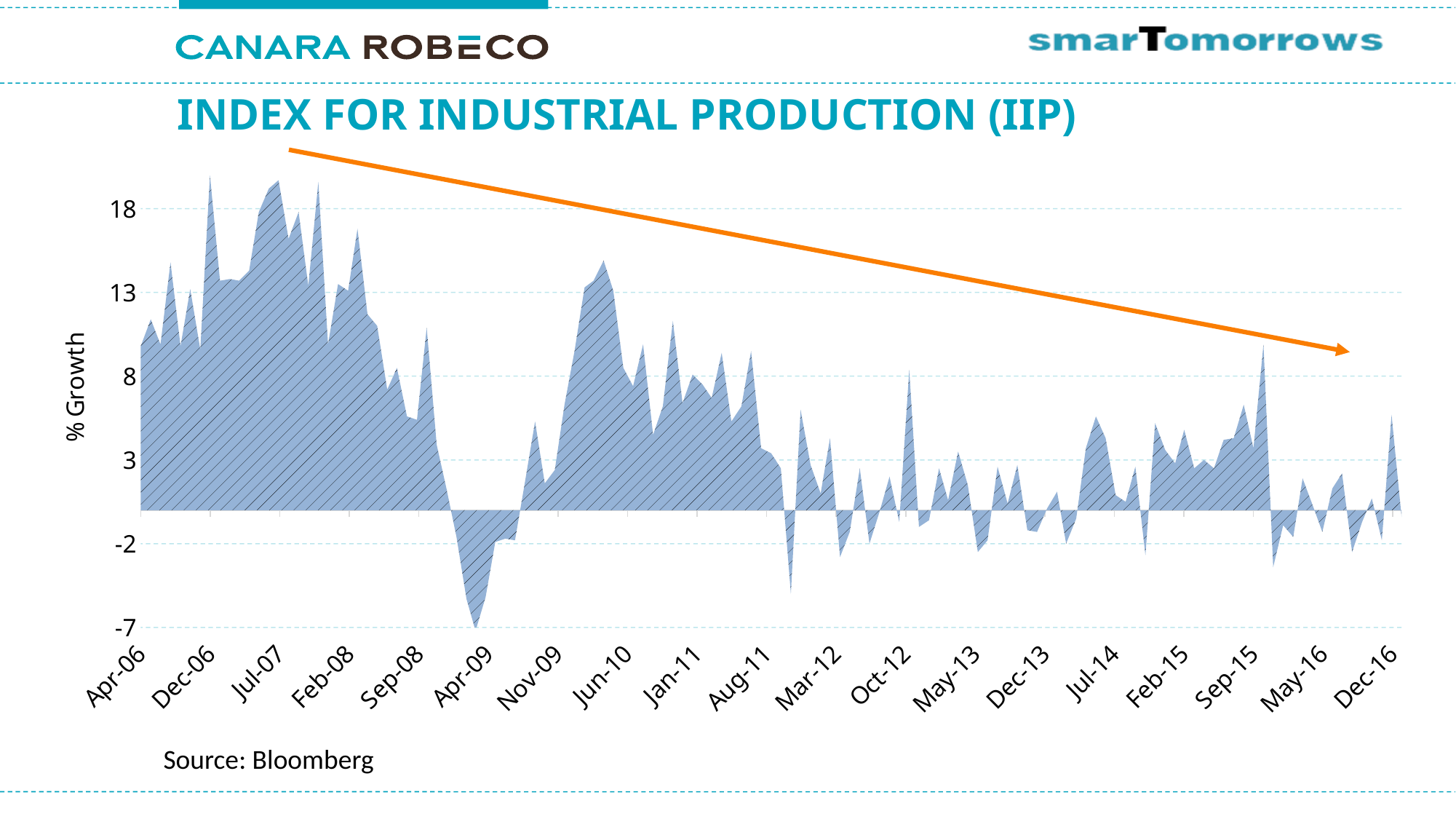
What is the title of the chart? INDEX FOR INDUSTRIAL PRODUCTION (IIP) Is the value for Nov-09 greater or less than 3? greater Is the value for Apr-06 greater or less than 8? greater How many date labels are shown along the x axis? 19 What is the lowest tick value shown on the vertical axis? -7 Is the value for Jul-07 greater or less than 13? greater What is the label on the vertical axis of the chart? % Growth Over the whole period from Apr-06 to Dec-16, does the IIP growth generally rise or fall? Fall Which of the labelled dates, Apr-09 or Jul-07, has the lower IIP growth value? Apr-09 What kind of chart is shown on the slide? Area chart